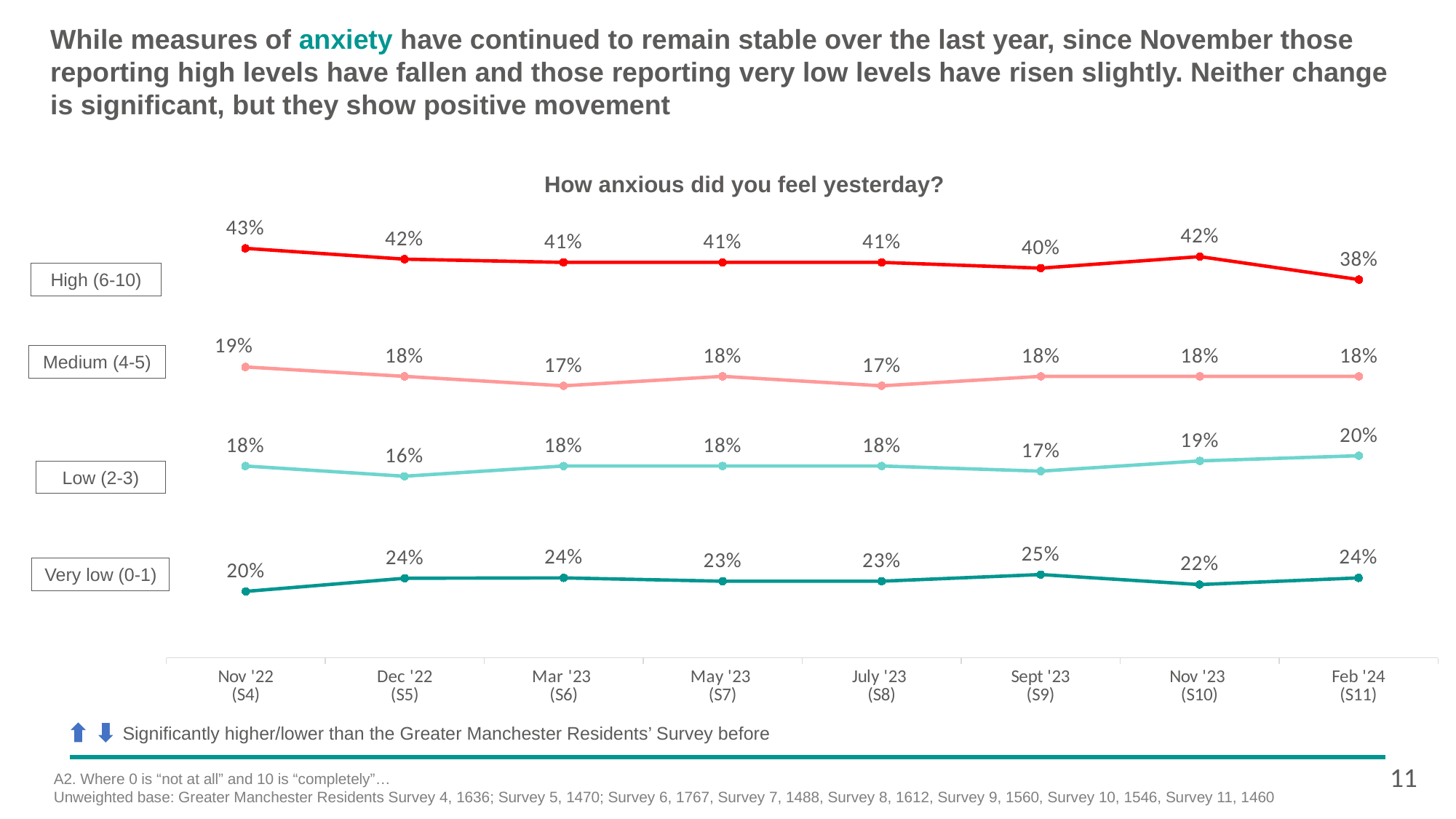
What is the value for Medium (4-5) in Mar '23 (S6)? 17% What is the value for Low (2-3) in Dec '22 (S5)? 16% In which survey wave is the High (6-10) series at its lowest? Feb '24 (S11) How many survey waves are shown on the x axis? 8 What is the value for Very low (0-1) in Nov '22 (S4)? 20% In which survey wave is the Very low (0-1) series at its highest? Sept '23 (S9) Which is larger in Feb '24 (S11): Low (2-3) or Medium (4-5)? Low (2-3) What is the value for High (6-10) in Feb '24 (S11)? 38% What type of chart is shown? Line chart In which survey wave is the High (6-10) series at its highest? Nov '22 (S4) What is the difference between the High (6-10) value in Nov '22 (S4) and in Feb '24 (S11)? 5 percentage points How many series are plotted on the chart? 4